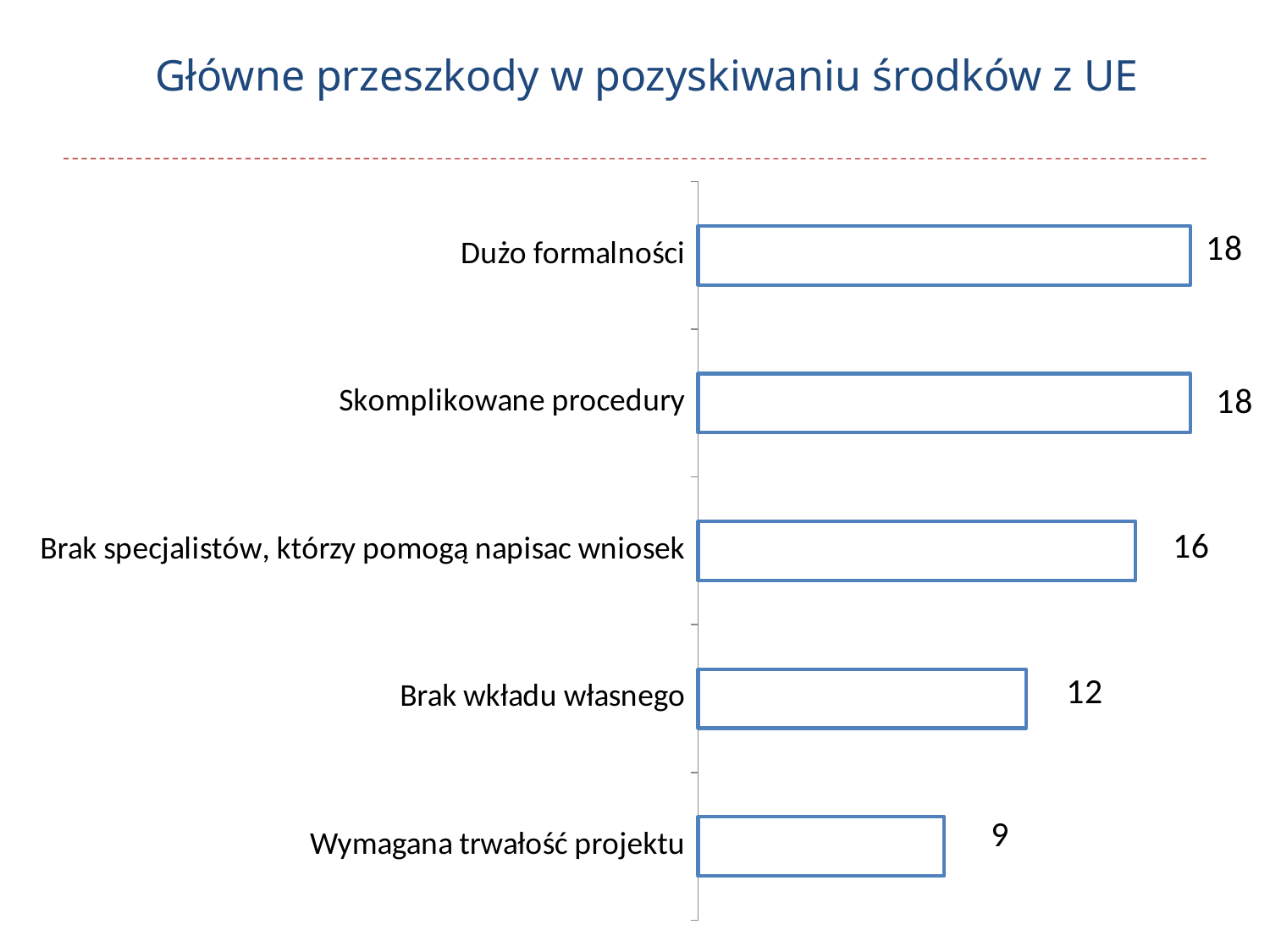
What is the value for "Brak specjalistów, którzy pomogą napisac wniosek"? 16 What is the difference between the values for "Brak specjalistów, którzy pomogą napisac wniosek" and "Wymagana trwałość projektu"? 7 What is the difference between the values for "Skomplikowane procedury" and "Brak wkładu własnego"? 6 What kind of chart is shown on the slide? Bar chart What is the title of the slide? Główne przeszkody w pozyskiwaniu środków z UE What is the value for "Wymagana trwałość projektu"? 9 What is the value for "Brak wkładu własnego"? 12 What is the value for "Dużo formalności"? 18 Which is larger, the value for "Dużo formalności" or the value for "Brak specjalistów, którzy pomogą napisac wniosek"? Dużo formalności Which is larger, the value for "Brak wkładu własnego" or the value for "Wymagana trwałość projektu"? Brak wkładu własnego Which category has the lowest value? Wymagana trwałość projektu How many categories are shown in the chart? 5